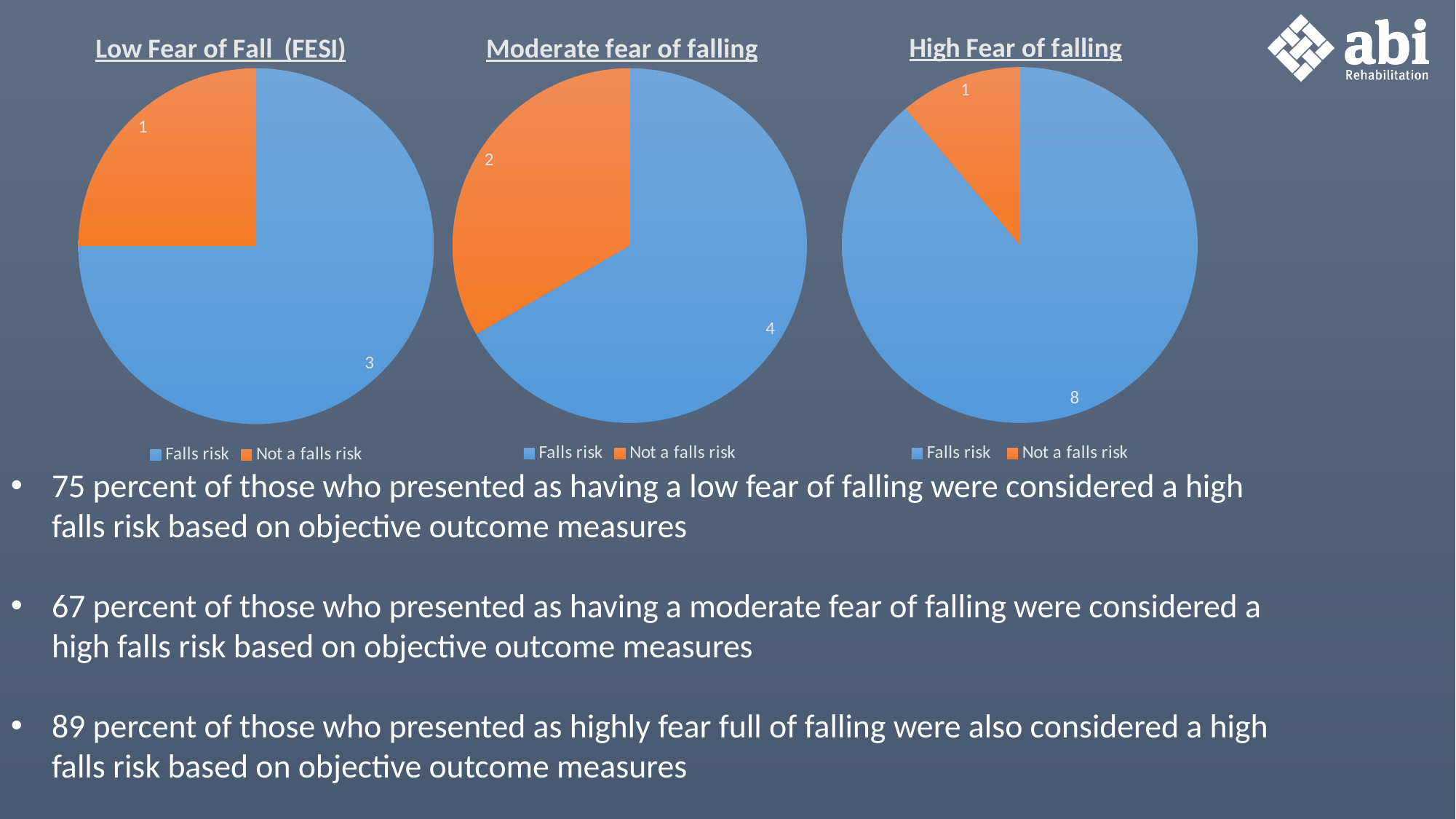
In the 'High Fear of falling' pie chart, what is the total of all slices? 9 In the 'Moderate fear of falling' pie chart, what is the value for 'Not a falls risk'? 2 In the 'High Fear of falling' pie chart, which slice is the largest? Falls risk In the 'Low Fear of Fall (FESI)' pie chart, what is the value for 'Not a falls risk'? 1 In the 'High Fear of falling' pie chart, what is the value for 'Falls risk'? 8 In the 'Moderate fear of falling' pie chart, what is the difference between 'Falls risk' and 'Not a falls risk'? 2 In the 'Low Fear of Fall (FESI)' pie chart, what share of the total does 'Falls risk' represent? 75% In the 'Low Fear of Fall (FESI)' pie chart, what is the value for 'Falls risk'? 3 In the 'Moderate fear of falling' pie chart, what is the value for 'Falls risk'? 4 How many series does the legend of the 'High Fear of falling' chart list? 2 In the 'High Fear of falling' pie chart, what is the value for 'Not a falls risk'? 1 What type of chart is used for 'Moderate fear of falling'? Pie chart